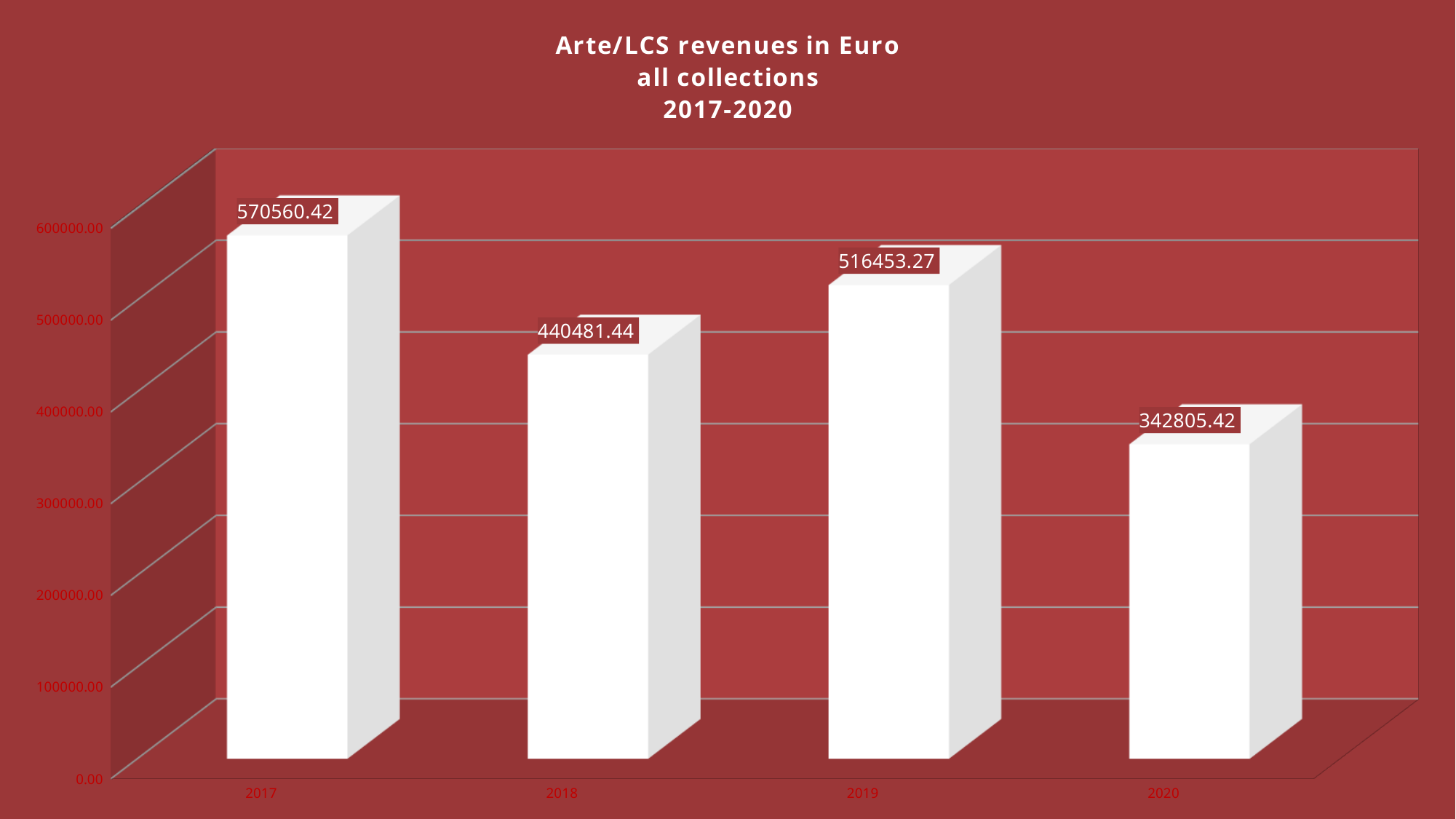
What kind of chart is shown on the slide? Bar chart What is the revenue value shown for 2020? 342805.42 Does the revenue rise or fall from 2019 to 2020? Fall What is the difference between the 2017 and 2018 revenue values? 130078.98 Which year has the highest revenue? 2017 What is the difference between the 2019 and 2020 revenue values? 173647.85 What is the revenue value shown for 2019? 516453.27 What is the revenue value shown for 2018? 440481.44 Which year has the larger revenue, 2018 or 2019? 2019 What is the revenue value shown for 2017? 570560.42 How many years are plotted on the chart? 4 Which year has the lowest revenue? 2020